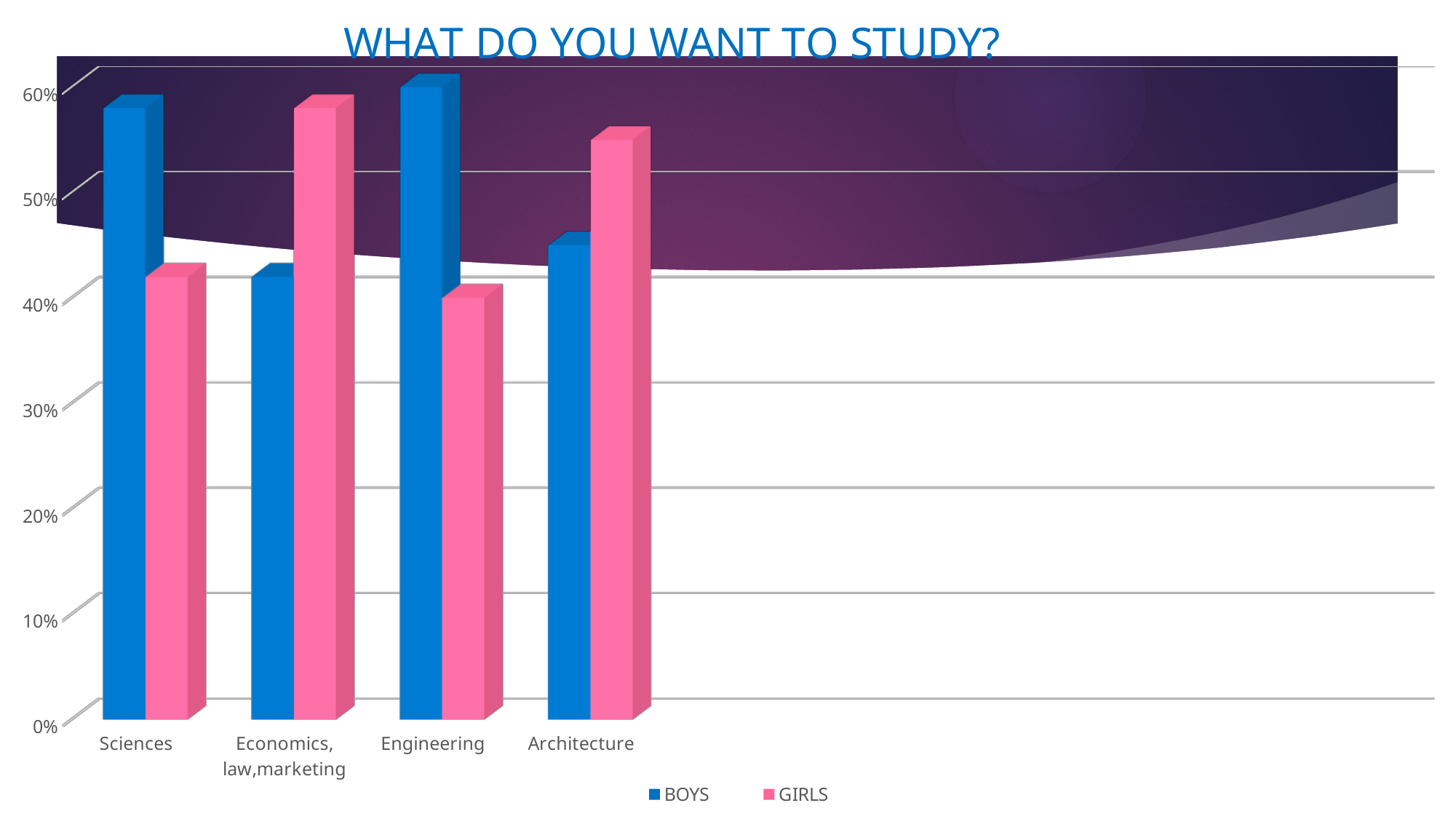
Is the GIRLS value for Engineering greater or less than 50%? less Is the GIRLS value for Architecture greater or less than 50%? greater What kind of chart is shown on the slide? bar chart Is the GIRLS value for Sciences greater or less than 50%? less How many series does the legend list? 2 How many categories are shown on the x axis? 4 For Economics, law,marketing, which series has the larger value, BOYS or GIRLS? GIRLS What is the title of the chart? WHAT DO YOU WANT TO STUDY? For Engineering, which series has the larger value, BOYS or GIRLS? BOYS Which category has the highest GIRLS value? Economics, law,marketing